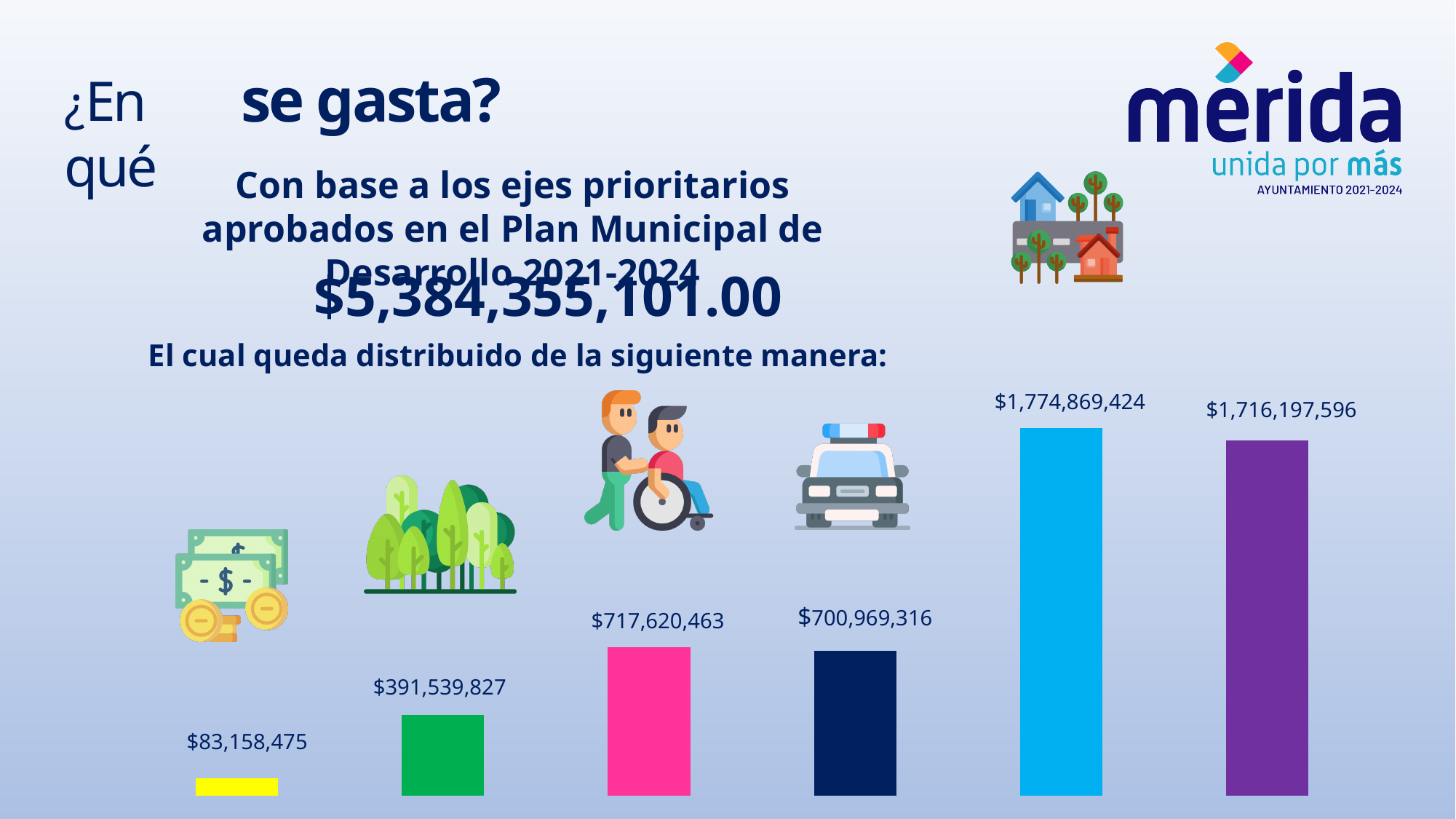
Which is larger, the pink bar or the dark navy bar? The pink bar What is the difference between the pink bar and the dark navy bar? $16,651,147 What value is shown above the purple bar on the far right? $1,716,197,596 What type of chart is shown on the slide? Bar chart How many bars are in the chart? 6 What value is shown above the yellow bar? $83,158,475 Which bar has the highest value? The light blue bar ($1,774,869,424) What value is shown above the green bar? $391,539,827 What value is shown above the pink bar? $717,620,463 What value is shown above the dark navy bar? $700,969,316 Which bar has the lowest value? The yellow bar ($83,158,475) What is the difference between the light blue bar and the purple bar? $58,671,828